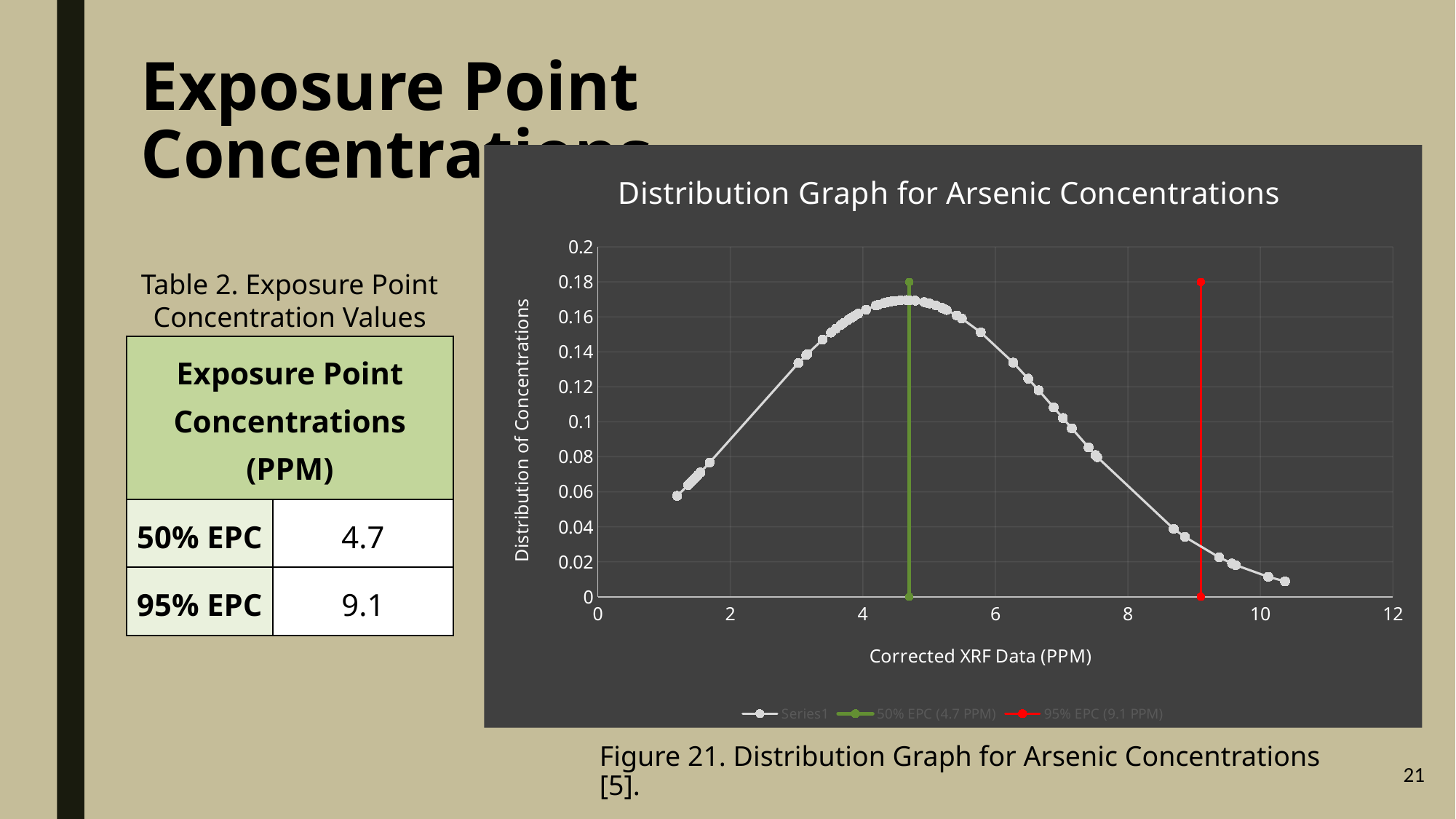
Is the peak value of the Series1 curve greater or less than 0.16? greater What is the title of the chart? Distribution Graph for Arsenic Concentrations At what x-axis value is the 95% EPC vertical line drawn, according to the legend? 9.1 PPM What is the highest tick value shown on the y axis? 0.2 How does the Series1 curve behave as the x-axis value increases from 1 to 10? It rises to a peak near 4.7 and then falls At what x-axis value is the 50% EPC vertical line drawn, according to the legend? 4.7 PPM How many series does the chart legend list? 3 Which vertical line is further to the right on the chart, the 50% EPC line or the 95% EPC line? 95% EPC Is the value of the Series1 curve at its right-most point (near x = 10.4) greater or less than 0.02? less What is the label of the x axis of the chart? Corrected XRF Data (PPM) What type of chart is shown on the slide? Line chart What is the highest tick value shown on the x axis? 12